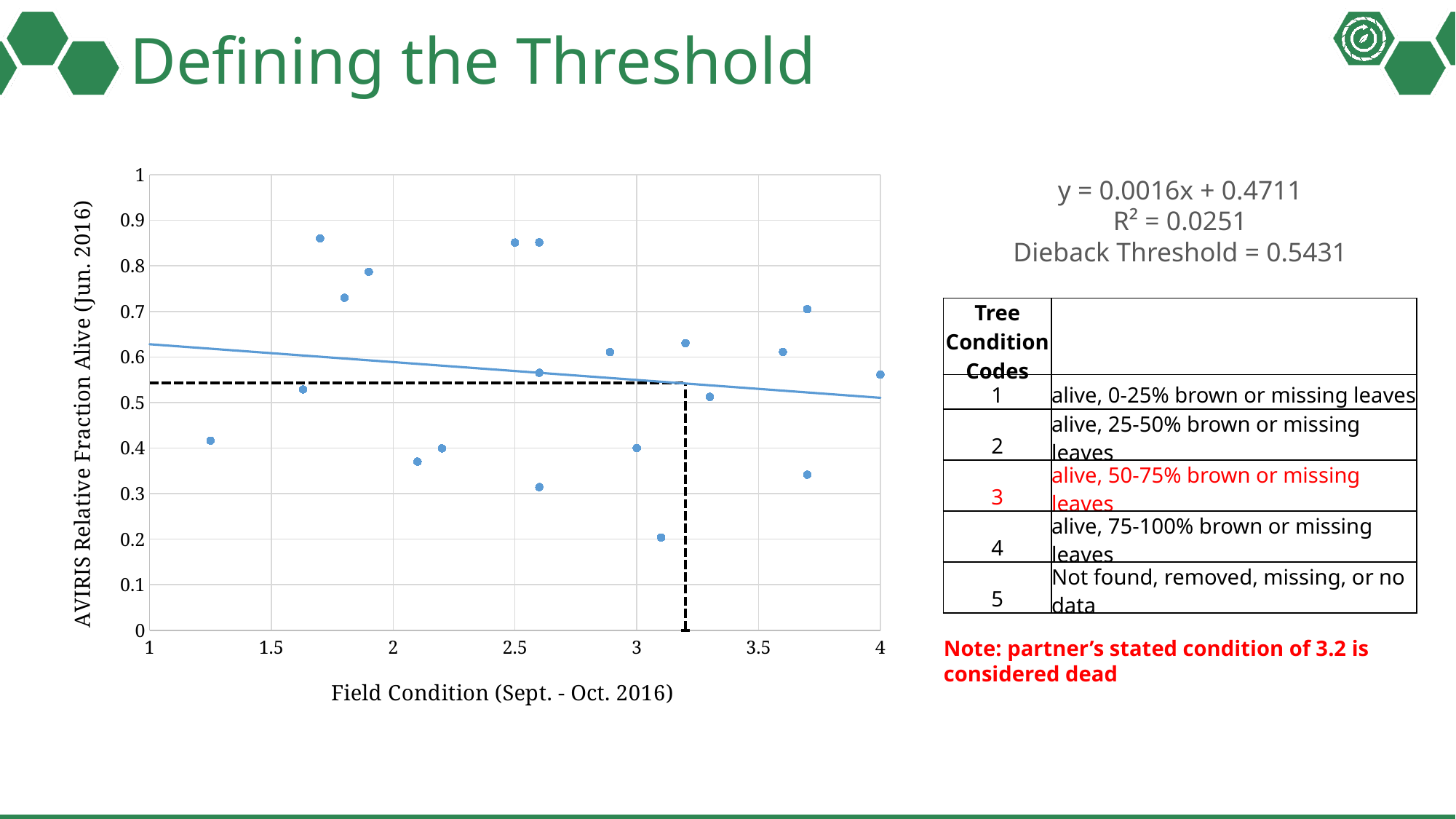
What R² value is reported for the trend line? 0.0251 What is the title of the y axis of the chart? AVIRIS Relative Fraction Alive (Jun. 2016) What is the maximum value shown on the y axis of the chart? 1 Is the AVIRIS Relative Fraction Alive for the point at Field Condition 3 greater or less than 0.5? less What kind of chart is shown on the slide? Scatter chart What is the equation of the trend line shown for the chart? y = 0.0016x + 0.4711 Is the AVIRIS Relative Fraction Alive for the point at Field Condition 4 greater or less than 0.5? greater Does the trend line rise or fall as Field Condition increases from 1 to 4? Falls What is the minimum value shown on the x axis of the chart? 1 What is the Dieback Threshold value stated next to the chart? 0.5431 What is the title of the x axis of the chart? Field Condition (Sept. - Oct. 2016) Is the lowest plotted point's AVIRIS Relative Fraction Alive greater or less than 0.3? less